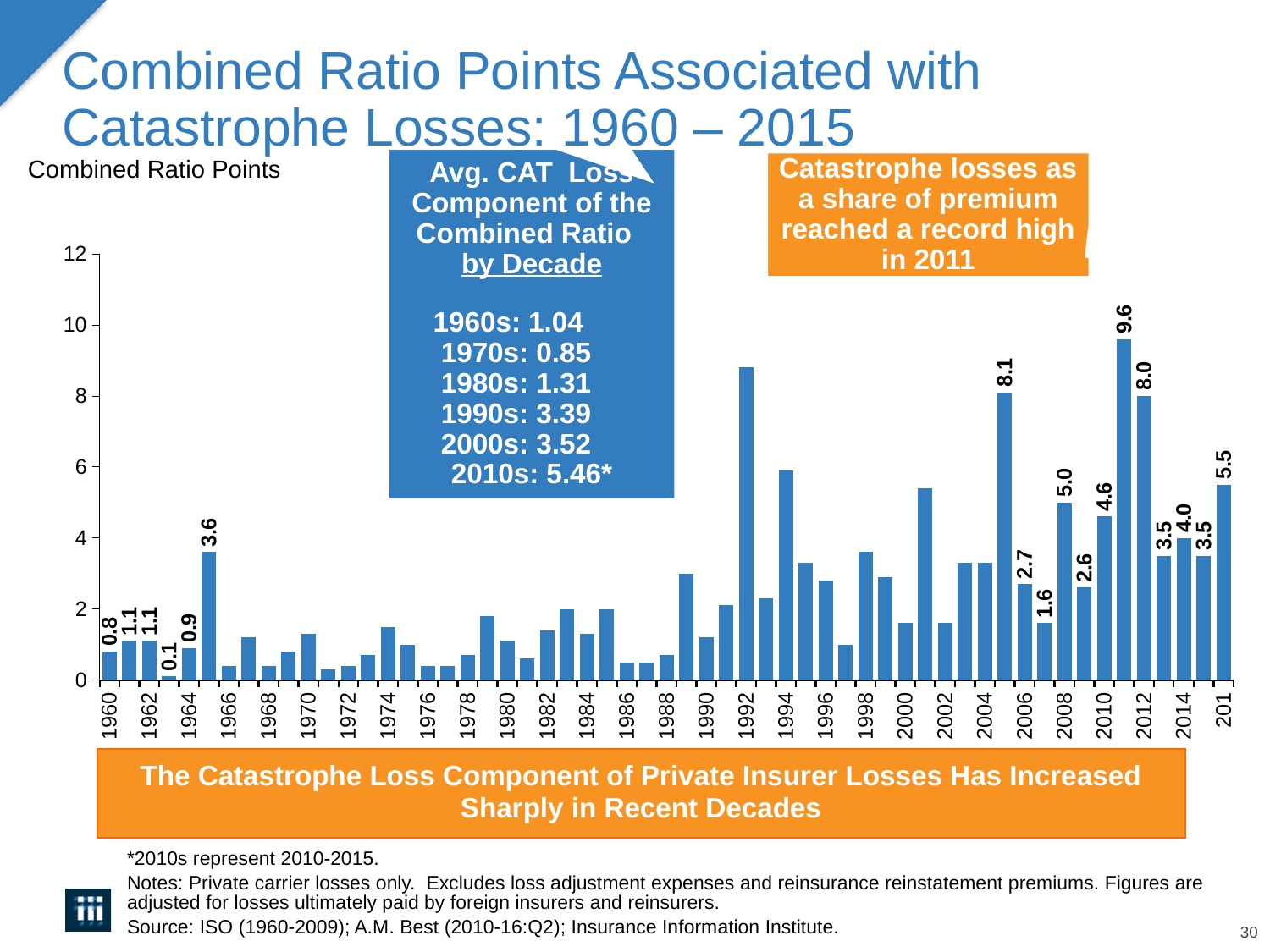
What is the difference between the values for 2005 and 2006? 5.4 Is the value for 1992 greater or less than 8? greater What is the value of combined ratio points for 2005? 8.1 What is the value of combined ratio points for 1965? 3.6 Which year has the larger value, 2008 or 2010? 2008 Which year has the lowest combined ratio points in the chart? 1963 What is the difference between the values for 2011 and 2012? 1.6 What is the value of combined ratio points for 1960? 0.8 What kind of chart is shown on the slide? bar chart Which year has the highest combined ratio points associated with catastrophe losses? 2011 What is the value of combined ratio points for 2011? 9.6 According to the text box on the chart, what was the average CAT loss component of the combined ratio in the 1990s? 3.39